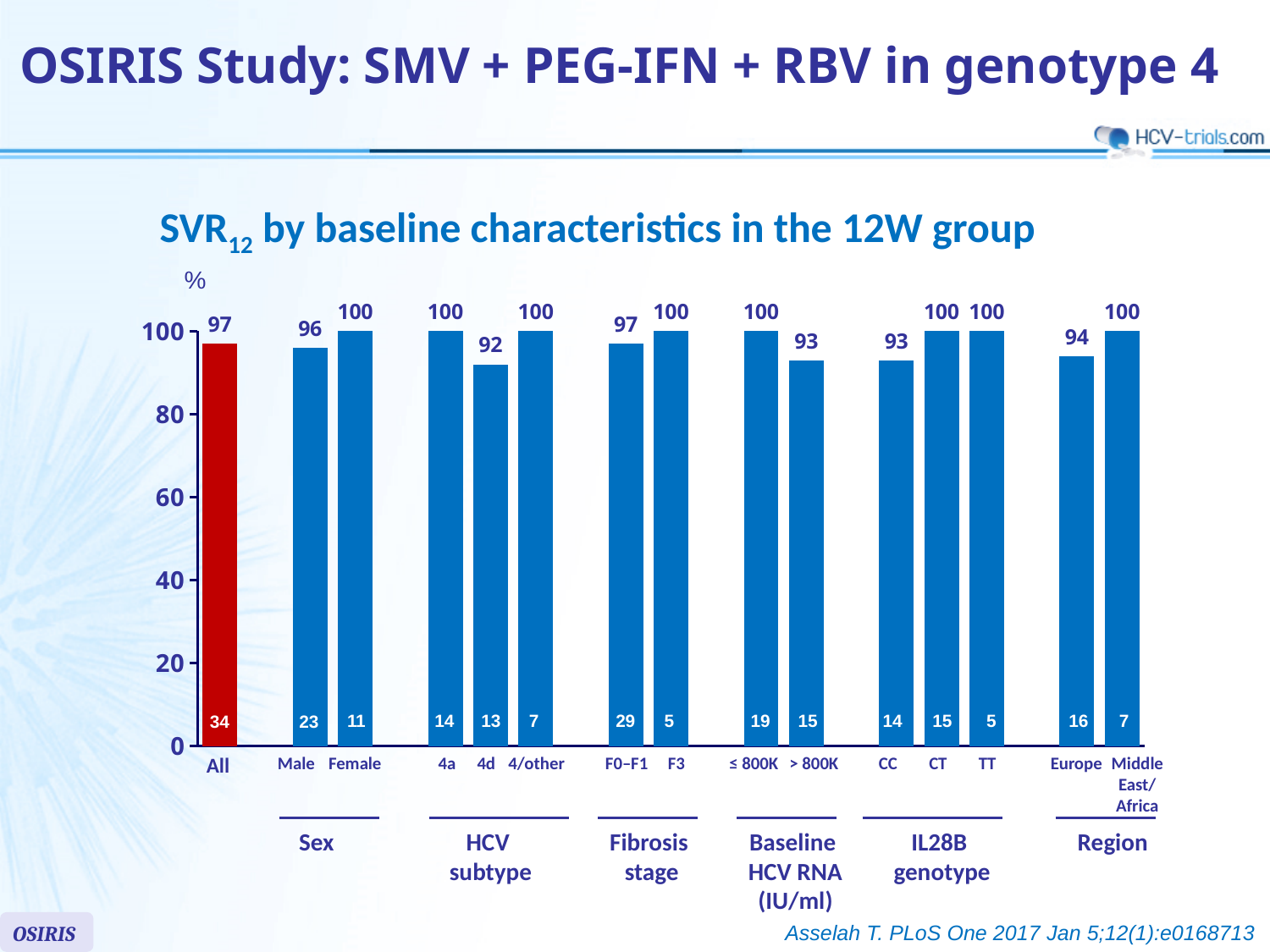
Which bar is coloured red rather than blue? All What is the difference in SVR12 between the CT and CC IL28B genotypes? 7 How many patients are in the Male group, as shown inside the bar? 23 What is the SVR12 value for the Europe region? 94 What is the SVR12 value for the 4d HCV subtype? 92 How many bars are plotted in the chart? 15 What type of chart is shown? Bar chart What is the SVR12 value for patients with baseline HCV RNA > 800K IU/ml? 93 What is the SVR12 value for the All group? 97 Which has a higher SVR12 value, F0–F1 or F3? F3 What is the difference in SVR12 between Female and Male? 4 Which category has the lowest SVR12 value? 4d